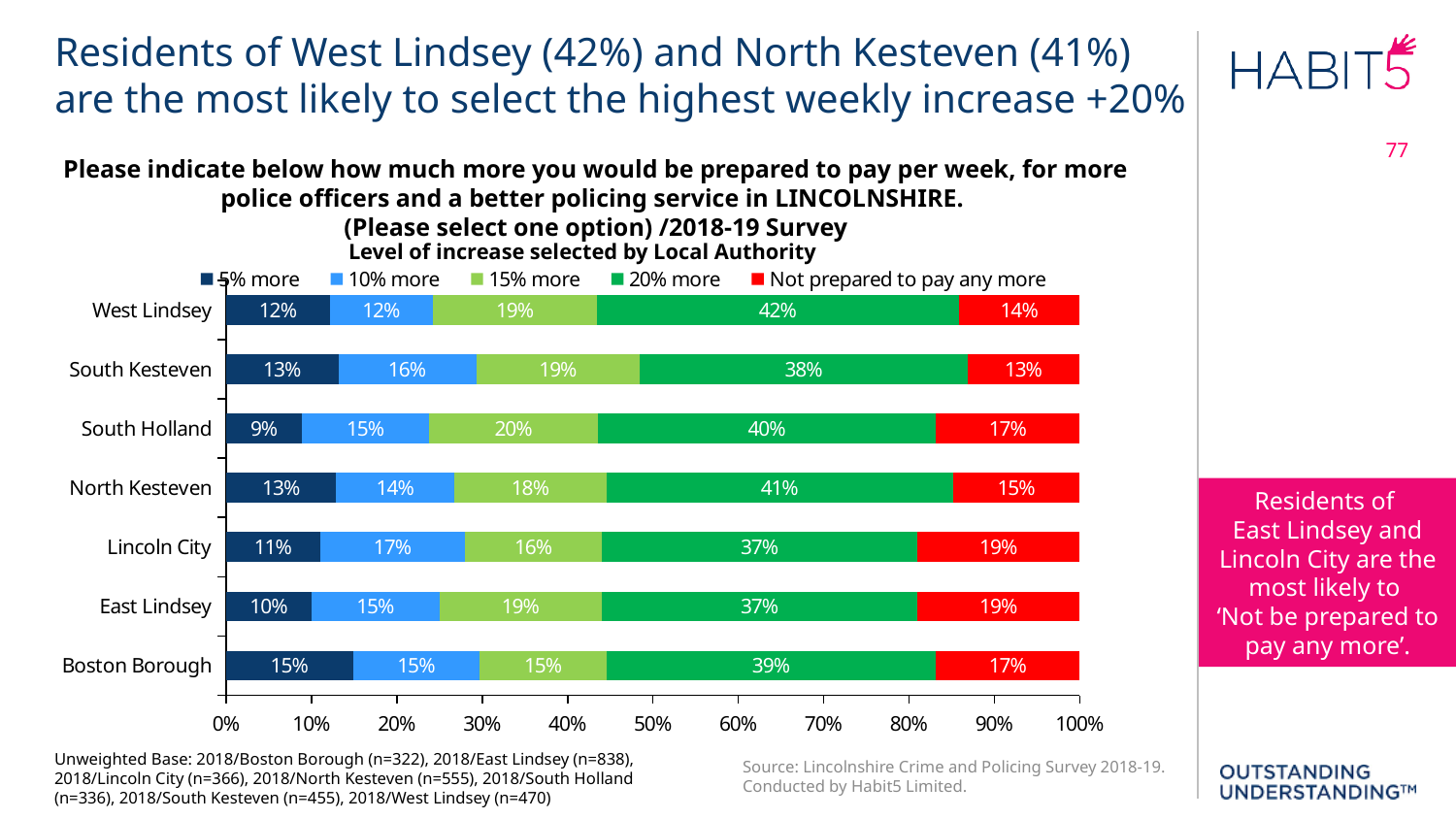
How many series does the legend list? 5 What is the title of the chart? Level of increase selected by Local Authority What percentage of Lincoln City residents were 'Not prepared to pay any more'? 19% How many local authorities are shown in the chart? 7 What percentage of West Lindsey residents selected '20% more'? 42% Which local authority has the lowest share selecting '5% more'? South Holland What type of chart is shown on the slide? Stacked bar chart Which has a larger share selecting '15% more': South Holland or Boston Borough? South Holland Which local authority has the highest share selecting '5% more'? Boston Borough What is the difference in percentage points between West Lindsey and South Kesteven for '20% more'? 4 percentage points What percentage of South Holland residents selected '15% more'? 20% Which local authority has the highest share selecting '20% more'? West Lindsey